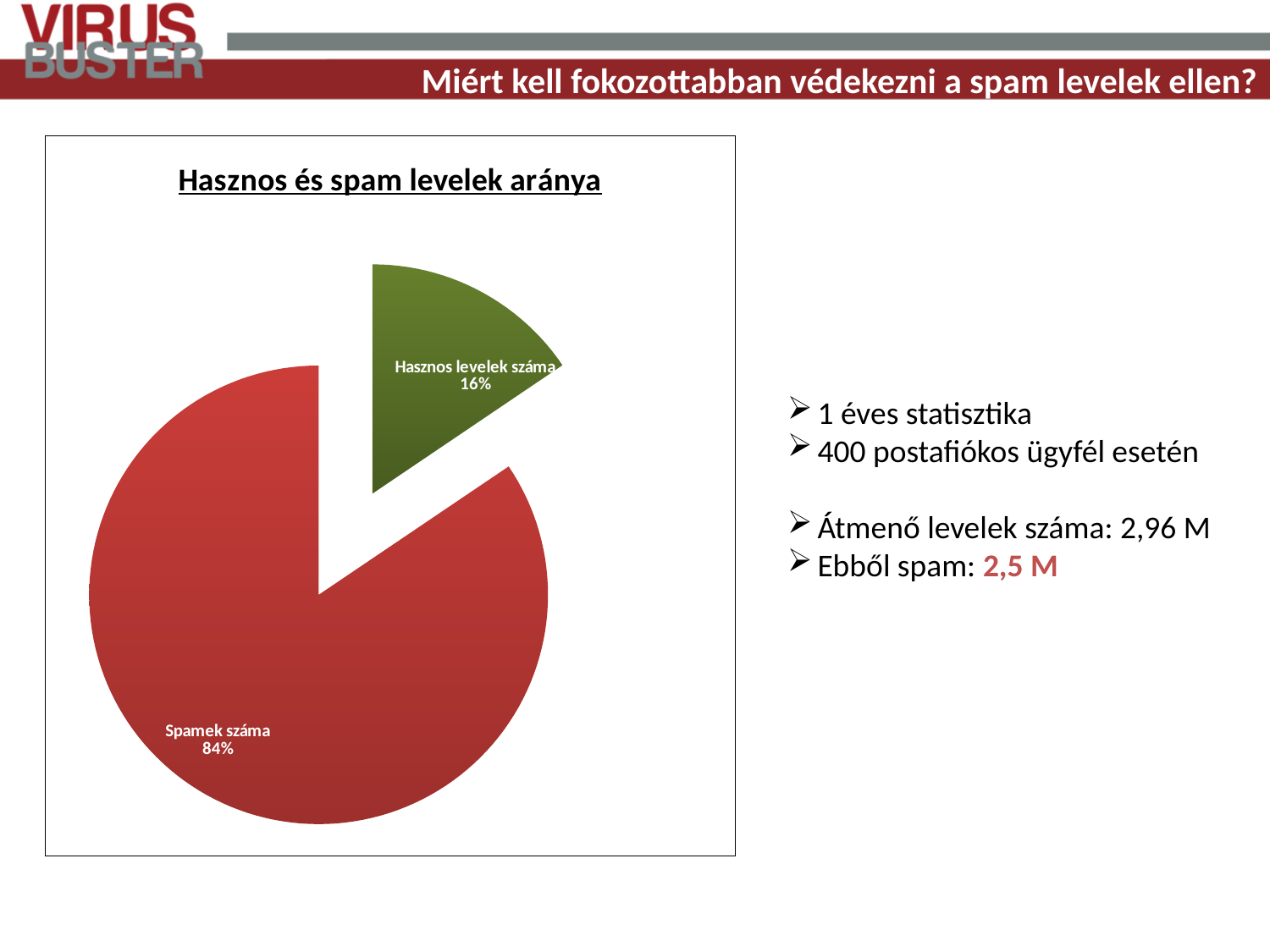
Which slice of the pie is the largest? Spamek száma What is the difference in percentage points between the "Spamek száma" and "Hasznos levelek száma" slices? 68 Which slice of the pie is the smallest? Hasznos levelek száma Which is larger, the "Spamek száma" slice or the "Hasznos levelek száma" slice? Spamek száma What kind of chart is shown on the slide? pie chart Is the share for "Spamek száma" greater or less than 50%? greater What colour is the "Hasznos levelek száma" slice? green What share of the pie does "Spamek száma" take? 84% How many slices does the pie chart have? 2 What is the title of the chart? Hasznos és spam levelek aránya What share of the pie does "Hasznos levelek száma" take? 16%